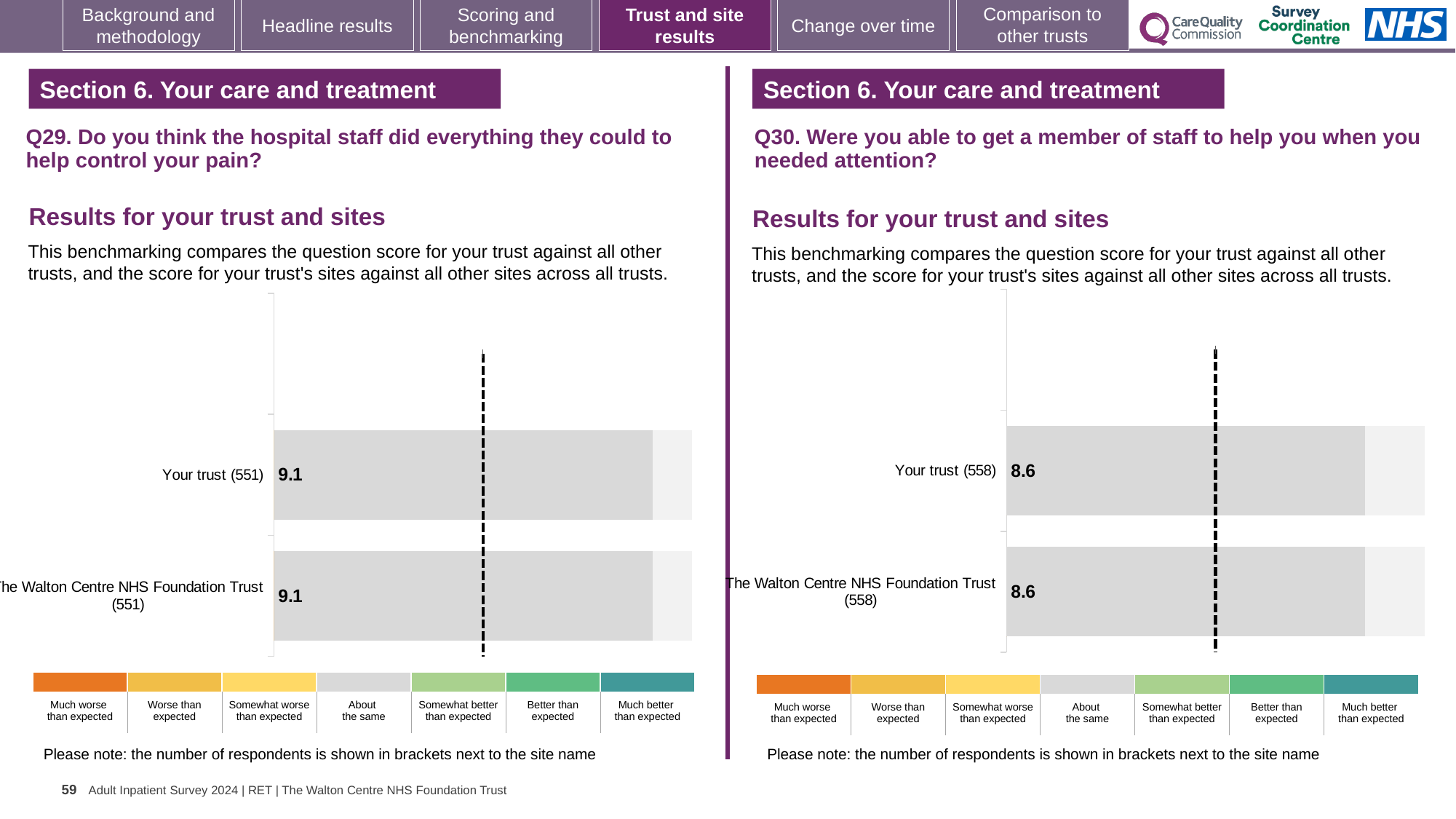
What kind of chart is used on the Q29 chart (left)? Bar chart On the Q29 chart (left), what is the score for The Walton Centre NHS Foundation Trust? 9.1 On the Q29 chart (left), what is the difference between the score for Your trust and the score for The Walton Centre NHS Foundation Trust? 0 On the Q30 chart (right), what is the score for Your trust? 8.6 How many bars are plotted on the Q30 chart (right)? 2 On the Q30 chart (right), what is the difference between the score for Your trust and the score for The Walton Centre NHS Foundation Trust? 0 On the Q30 chart (right), how many respondents are shown in brackets next to The Walton Centre NHS Foundation Trust? 558 Which question does the chart on the right of the slide relate to? Q30. Were you able to get a member of staff to help you when you needed attention? How many bars are plotted on the Q29 chart (left)? 2 On the Q30 chart (right), what is the score for The Walton Centre NHS Foundation Trust? 8.6 On the Q29 chart (left), how many respondents are shown in brackets next to Your trust? 551 On the Q29 chart (left), what is the score for Your trust? 9.1